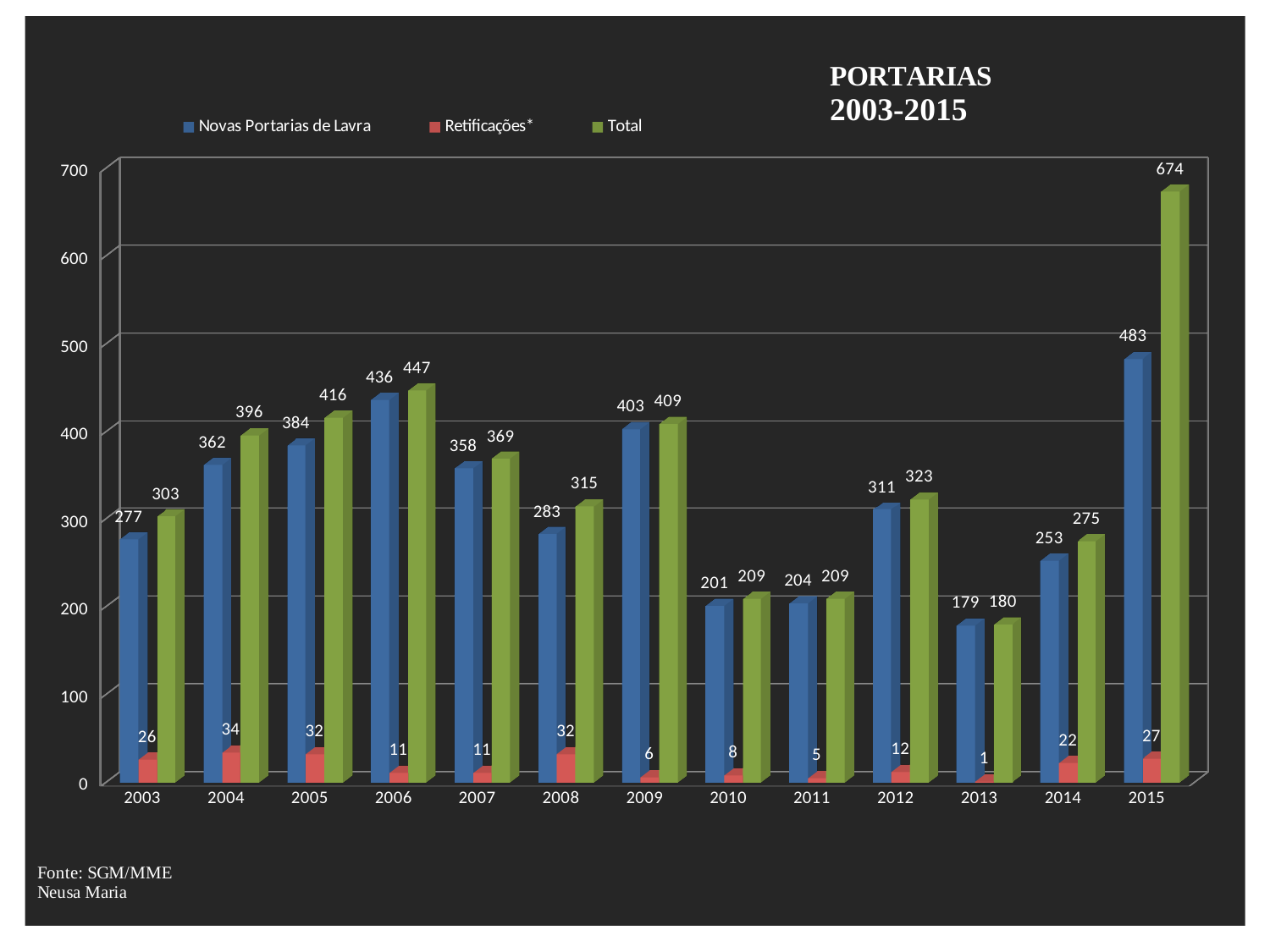
What is the title of the chart? PORTARIAS 2003-2015 What is the value of Novas Portarias de Lavra for 2006? 436 How many series does the legend list? 3 Which year has the lowest value for Retificações*? 2013 Which is larger: Novas Portarias de Lavra in 2005 or in 2007? 2005 How many years are shown on the x axis? 13 Is the Total value for 2009 greater or less than 400? greater What is the Total value for 2015? 674 Which year has the highest Total value? 2015 What is the difference between the Total values for 2015 and 2014? 399 What kind of chart is shown on the slide? Bar chart What is the value of Retificações* for 2004? 34